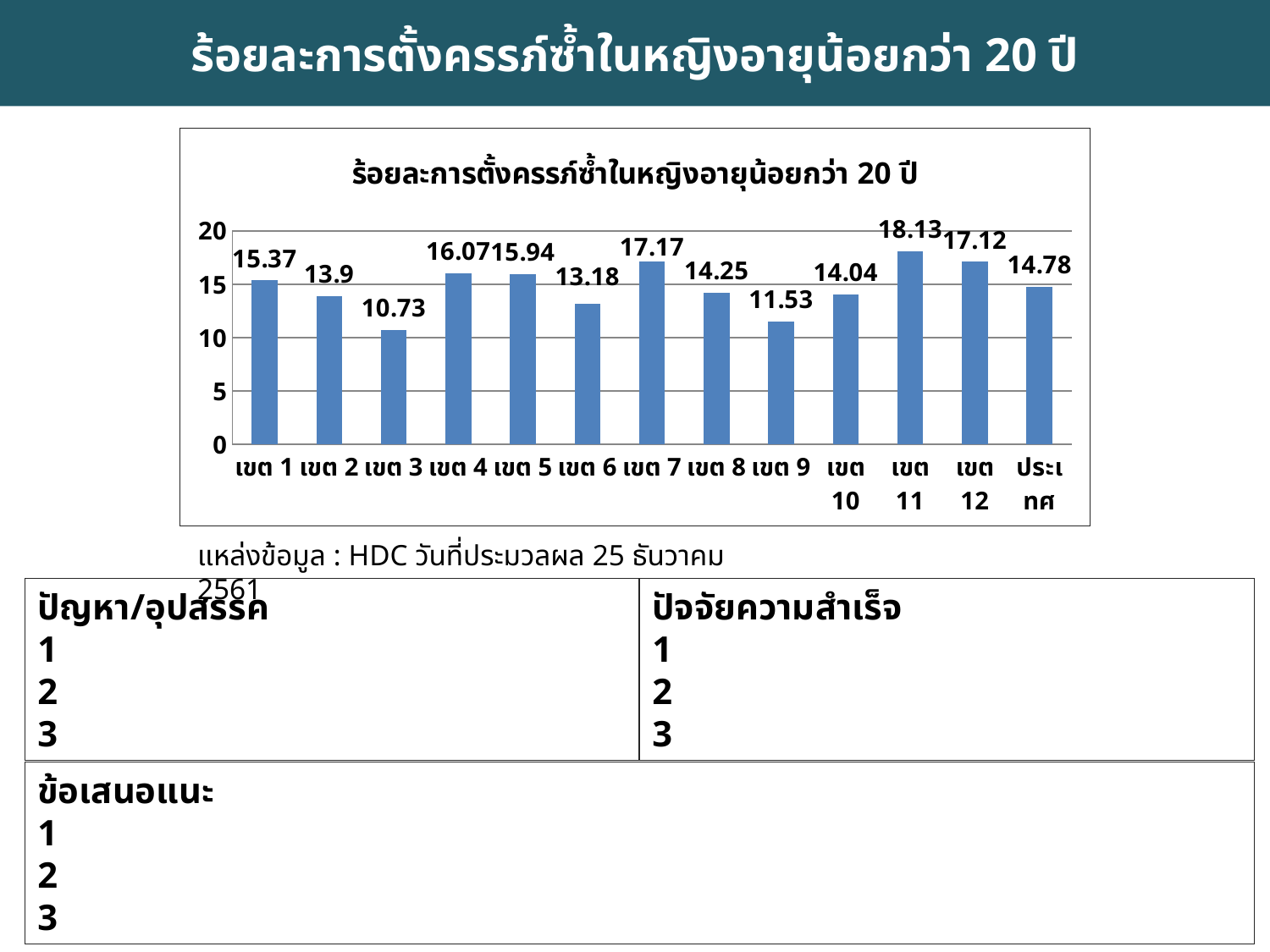
Which is larger, the value for เขต 9 or the value for เขต 10? เขต 10 What is the value for ประเทศ? 14.78 Which category has the lowest value? เขต 3 How many categories are shown on the x axis? 13 What is the title of the chart? ร้อยละการตั้งครรภ์ซ้ำในหญิงอายุน้อยกว่า 20 ปี Is the value for เขต 12 greater or less than 15? greater Which category has the highest value? เขต 11 What is the value for เขต 3? 10.73 What is the difference between the values for เขต 11 and เขต 3? 7.4 What type of chart is shown on the slide? bar chart What is the value for เขต 11? 18.13 What is the value for เขต 7? 17.17